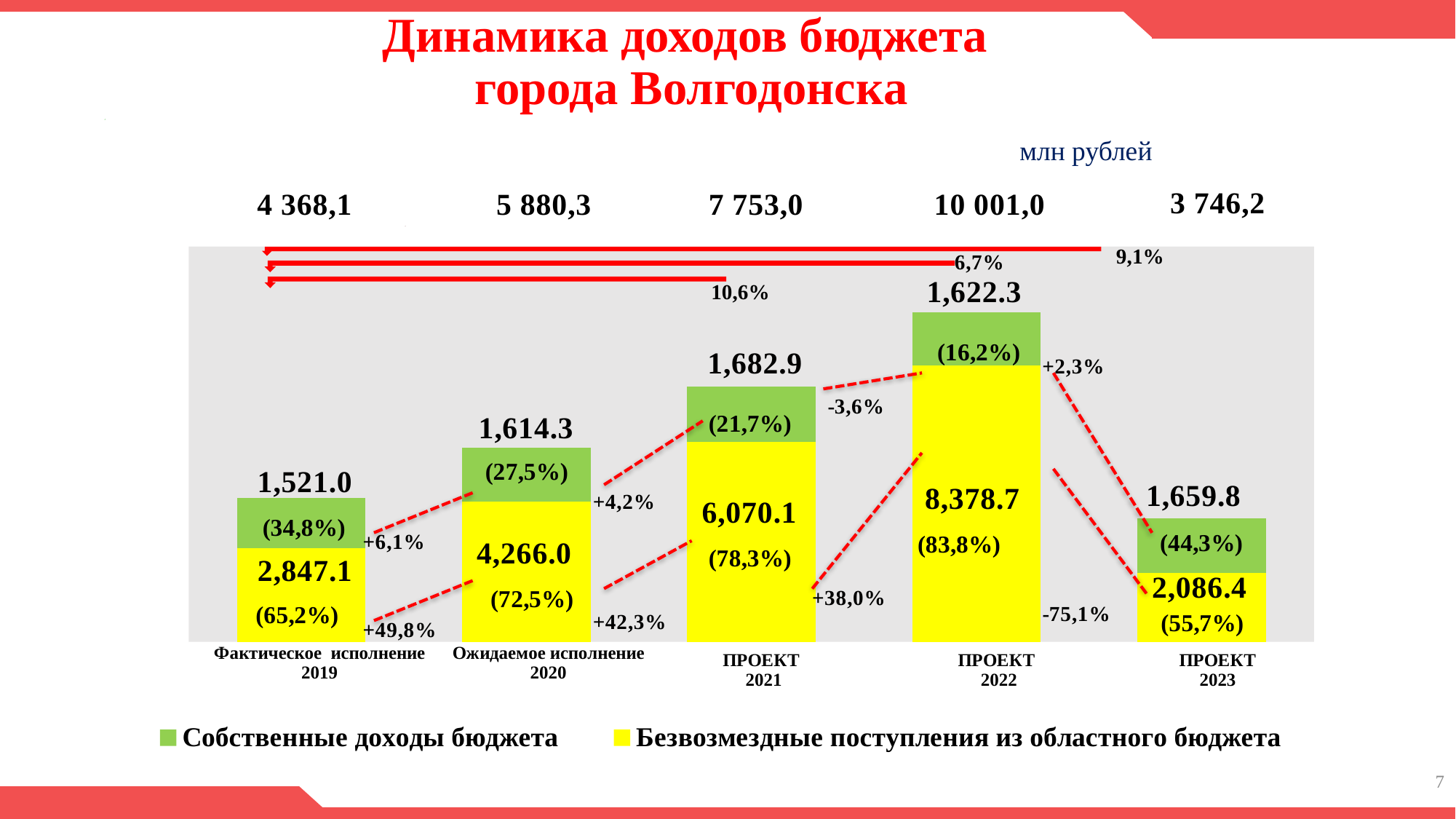
What is the difference between the yellow segment values for ПРОЕКТ 2022 and ПРОЕКТ 2021? 2,308.6 Which is larger: the yellow segment for Фактическое исполнение 2019 or the yellow segment for ПРОЕКТ 2023? Фактическое исполнение 2019 What is the value of the yellow segment (Безвозмездные поступления из областного бюджета) for Ожидаемое исполнение 2020? 4,266.0 What is the total budget revenue shown above the bar for ПРОЕКТ 2021? 7 753,0 What share of the ПРОЕКТ 2023 bar is the green segment (Собственные доходы бюджета)? 44,3% How many categories (years) are shown on the x axis of the chart? 5 What type of chart is shown on the slide? stacked bar chart How many series does the legend list? 2 Which year has the highest total budget revenue? ПРОЕКТ 2022 What unit of measurement is indicated for the chart? млн рублей What is the value of the green segment (Собственные доходы бюджета) for ПРОЕКТ 2022? 1,622.3 Which year has the lowest total budget revenue? ПРОЕКТ 2023